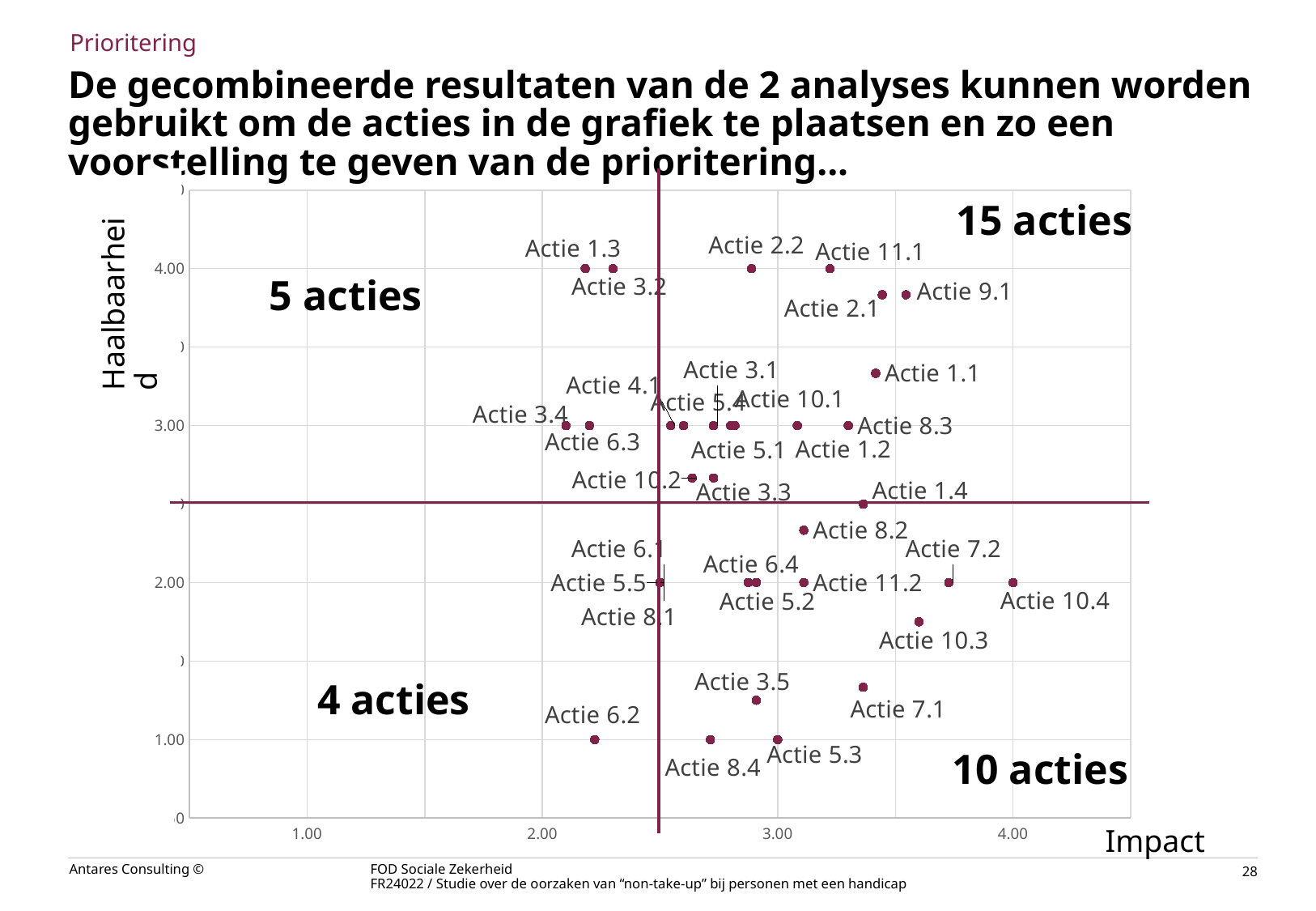
How many acties does the chart indicate in the top-right quadrant? 15 acties What is the Impact value of Actie 10.4? 4.00 Which has the higher Haalbaarheid value, Actie 9.1 or Actie 7.1? Actie 9.1 What kind of chart is shown on the slide? scatter plot Which actie has the highest Impact value? Actie 10.4 How many acties does the chart indicate in the bottom-left quadrant? 4 acties What is the label of the x axis of the chart? Impact Is the Haalbaarheid value for Actie 9.1 greater or less than 3.00? greater Is the Impact value for Actie 6.2 greater or less than 3.00? less How many acties does the chart indicate in the top-left quadrant? 5 acties What is the label of the y axis of the chart? Haalbaarheid What is the Haalbaarheid value of Actie 6.2? 1.00